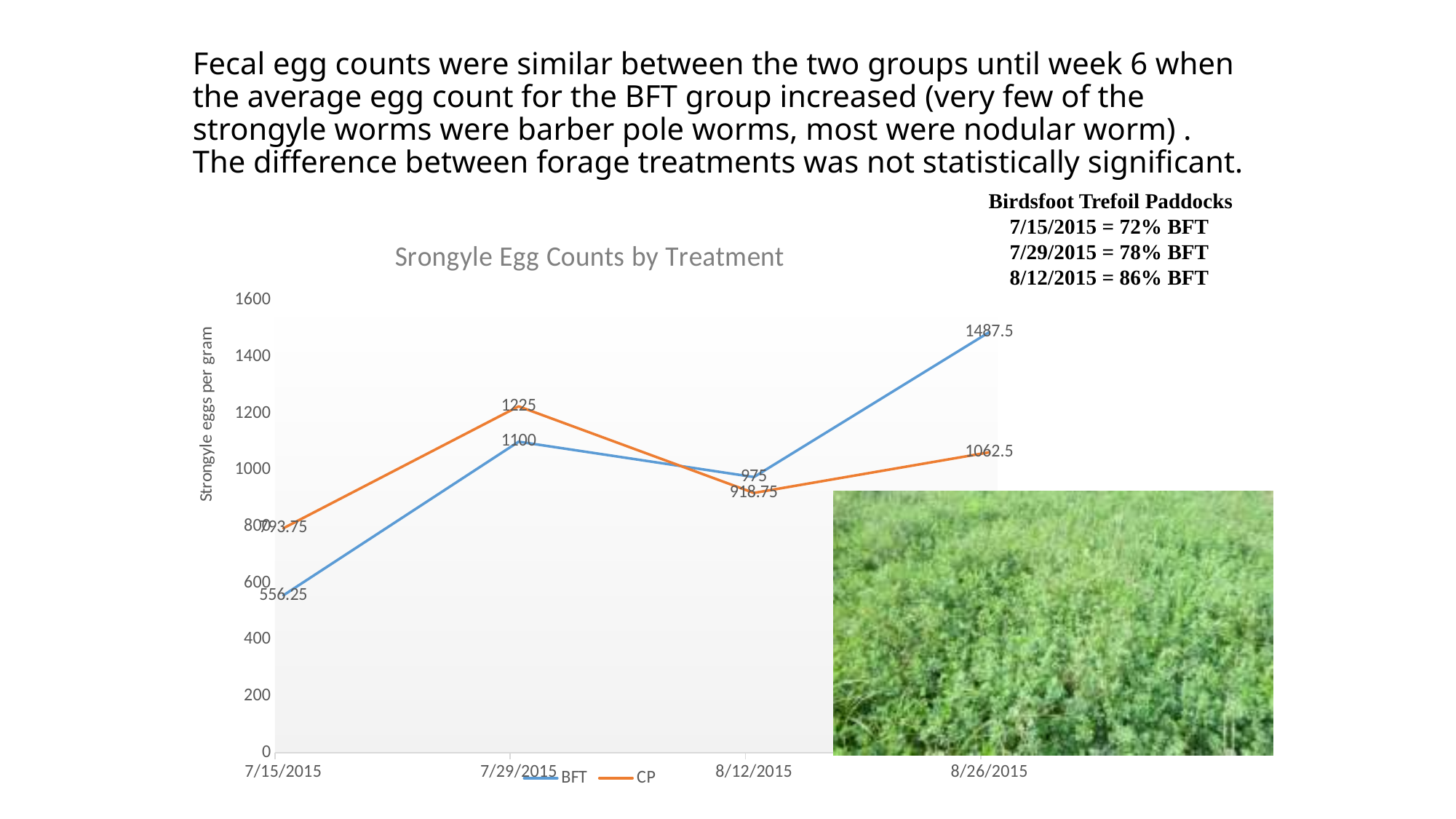
How many dates are plotted along the x axis of the chart? 4 What is the BFT value on 7/15/2015? 556.25 How many series does the legend of the chart list? 2 What is the label on the vertical axis of the chart? Strongyle eggs per gram What is the CP value on 7/29/2015? 1225 What is the difference between the BFT and CP values on 8/26/2015? 425 What is the CP value on 8/12/2015? 918.75 What kind of chart is shown on the slide? line chart What is the BFT value on 8/26/2015? 1487.5 On 7/29/2015, which series has the larger value, BFT or CP? CP On which date is the BFT series at its highest? 8/26/2015 On which date is the BFT series at its lowest? 7/15/2015